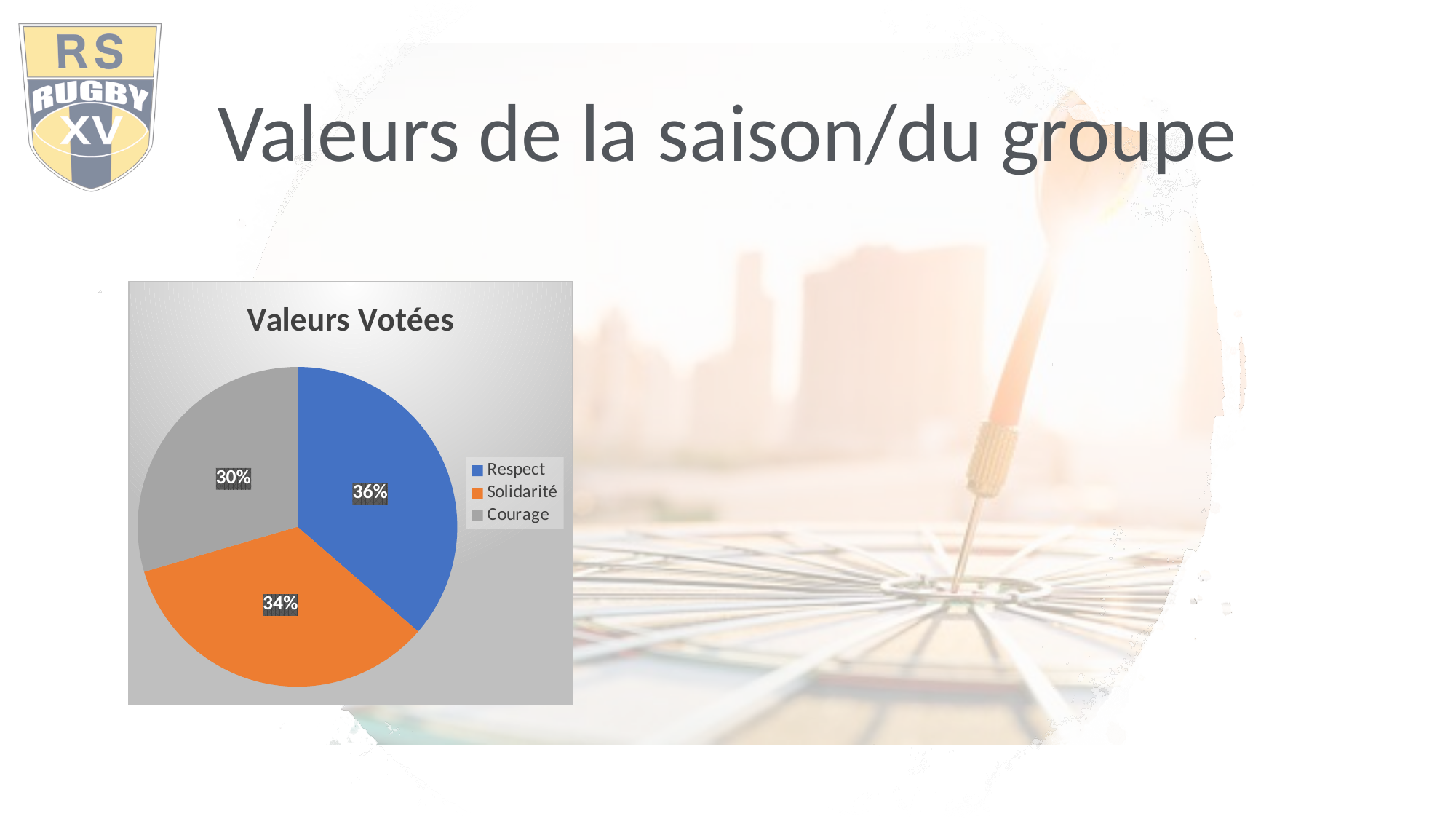
What share of the pie does Courage have? 30% What share of the pie does Respect have? 36% What share of the pie does Solidarité have? 34% How many slices does the pie chart have? 3 Which value received the largest share of votes? Respect Which colour represents Solidarité in the chart? orange Is the share for Courage greater or less than the share for Solidarité? less What is the difference between the shares for Solidarité and Courage? 4% What is the difference between the shares for Respect and Courage? 6% What kind of chart is shown on the slide? pie chart Which value received the smallest share of votes? Courage What is the title of the chart? Valeurs Votées